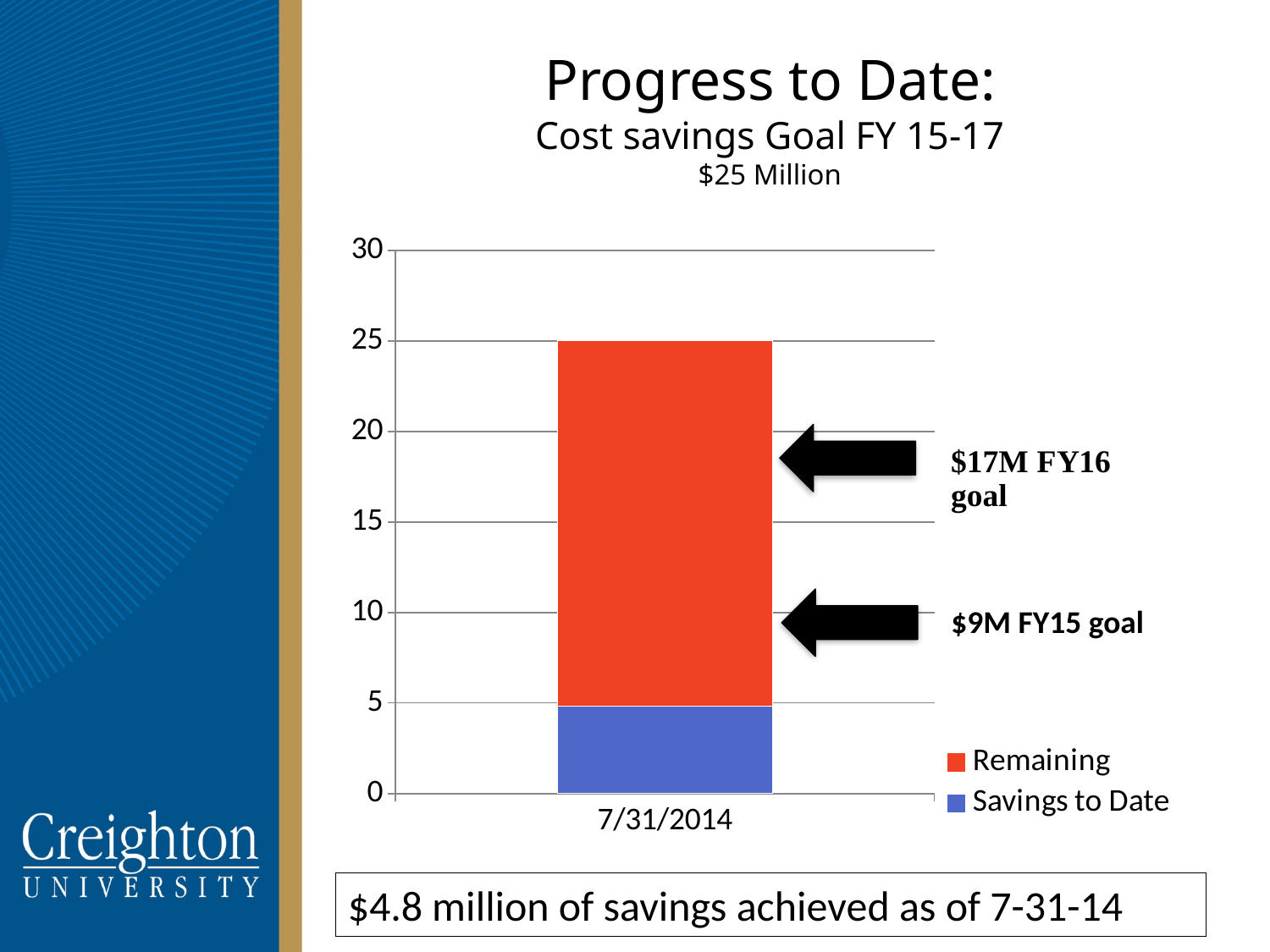
What kind of chart is shown on the slide? bar chart What are the two legend entries? Remaining, Savings to Date What is the value of Savings to Date as of 7/31/2014? $4.8 million Is the value for Remaining greater or less than 15? greater What is the total height of the stacked bar for 7/31/2014? 25 Which series is larger in the 7/31/2014 bar, Remaining or Savings to Date? Remaining What is the category label on the x axis? 7/31/2014 What is the cost savings goal stated in the chart title? $25 Million Given the $25 million goal and $4.8 million saved to date, how much remains in millions? 20.2 Is the value for Savings to Date greater or less than 5? less How many series does the legend list? 2 How many categories are plotted on the x axis? 1